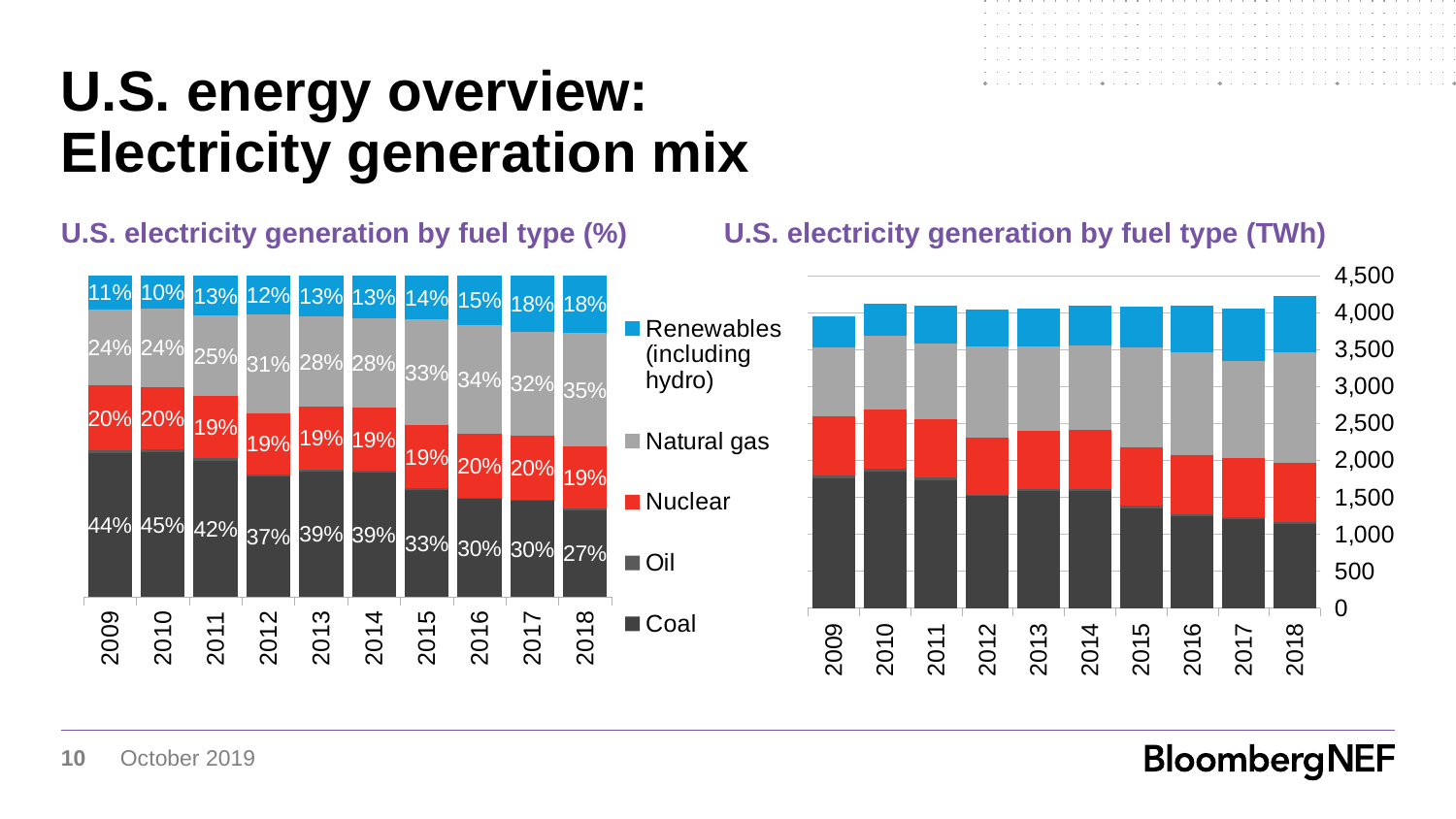
In the 'U.S. electricity generation by fuel type (%)' chart, what share of generation did coal have in 2009? 44% How many fuel types does the legend on the slide list? 5 In the 'U.S. electricity generation by fuel type (TWh)' chart, is the coal generation in 2018 greater or less than 1,500? less In the 'U.S. electricity generation by fuel type (%)' chart, which year has the lowest coal share? 2018 In the 'U.S. electricity generation by fuel type (%)' chart, which year has the highest natural gas share? 2018 In the 'U.S. electricity generation by fuel type (%)' chart, what was the natural gas share in 2018? 35% In the 'U.S. electricity generation by fuel type (%)' chart, by how many percentage points did the coal share fall from 2009 to 2018? 17 percentage points In the 'U.S. electricity generation by fuel type (%)' chart, what was the renewables share in 2017? 18% In the 'U.S. electricity generation by fuel type (%)' chart, which had the larger share in 2012, natural gas or nuclear? Natural gas How many years are shown on the x axis of the 'U.S. electricity generation by fuel type (TWh)' chart? 10 What kind of chart is the 'U.S. electricity generation by fuel type (TWh)' chart? Stacked bar chart In the 'U.S. electricity generation by fuel type (%)' chart, does the renewables share generally rise or fall from 2009 to 2018? Rise